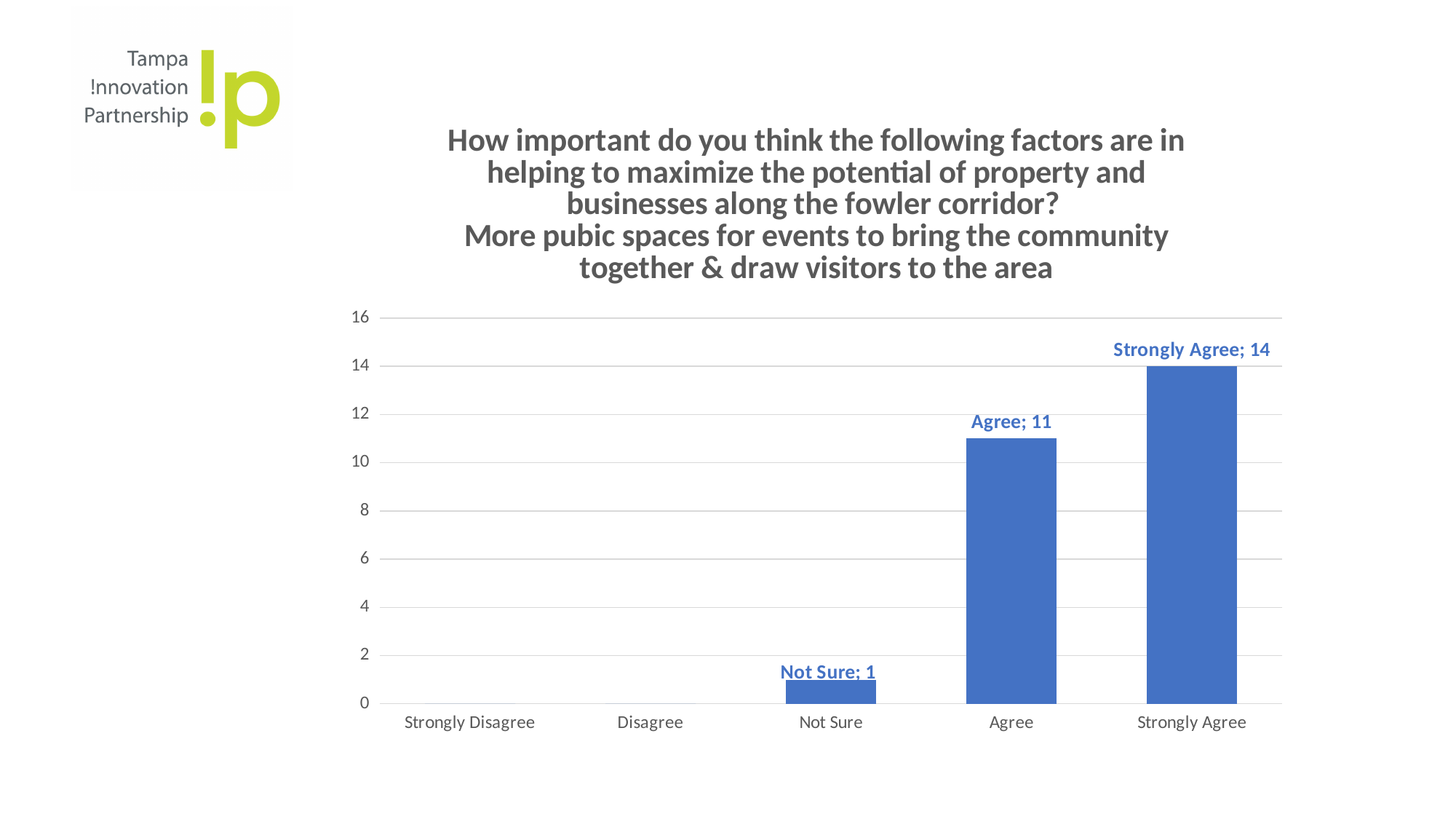
What is the difference between the values for Strongly Agree and Agree? 3 Which is larger, the value for Agree or the value for Strongly Agree? Strongly Agree How many categories are shown on the x axis? 5 Among the categories with visible bars, which has the lowest value? Not Sure What is the value for Strongly Agree? 14 What kind of chart is shown on the slide? Bar chart Which category has the highest value? Strongly Agree What is the difference between the values for Agree and Not Sure? 10 What is the value for Agree? 11 Is the value for Agree greater or less than 10? greater Do the values rise or fall moving from Not Sure to Strongly Agree along the x axis? Rise What is the value for Not Sure? 1